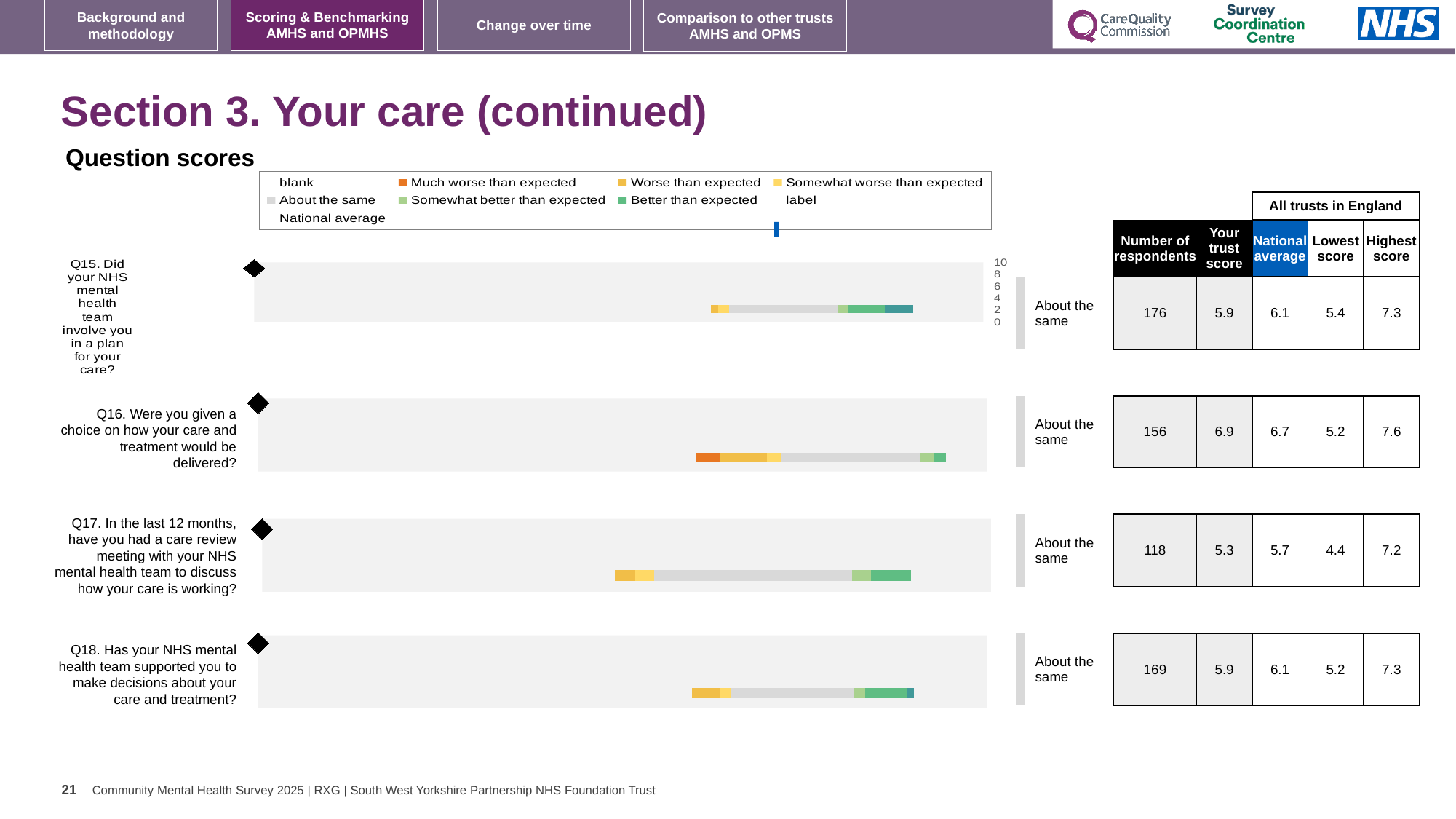
Which question (Q15 to Q18) has the highest 'Your trust score'? Q16 Which question (Q15 to Q18) has the lowest 'Your trust score'? Q17 For Q16, what is the difference between the highest score (7.6) and the lowest score (5.2) across all trusts in England? 2.4 In the table next to the charts, what is the 'Your trust score' value for Q16? 6.9 In the table next to the charts, what is the highest score across all trusts in England for Q16? 7.6 What type of chart is used to show the question scores for Q15 to Q18? bar chart For Q17, which is larger: the trust score or the national average? National average What comparison label is shown next to the Q18 chart? About the same In the table next to the charts, what is the number of respondents for Q15? 176 In the legend, what colour represents 'Much worse than expected'? Orange In the table next to the charts, what is the national average for Q17? 5.7 How many question charts (Q15 to Q18) are shown on the slide? 4